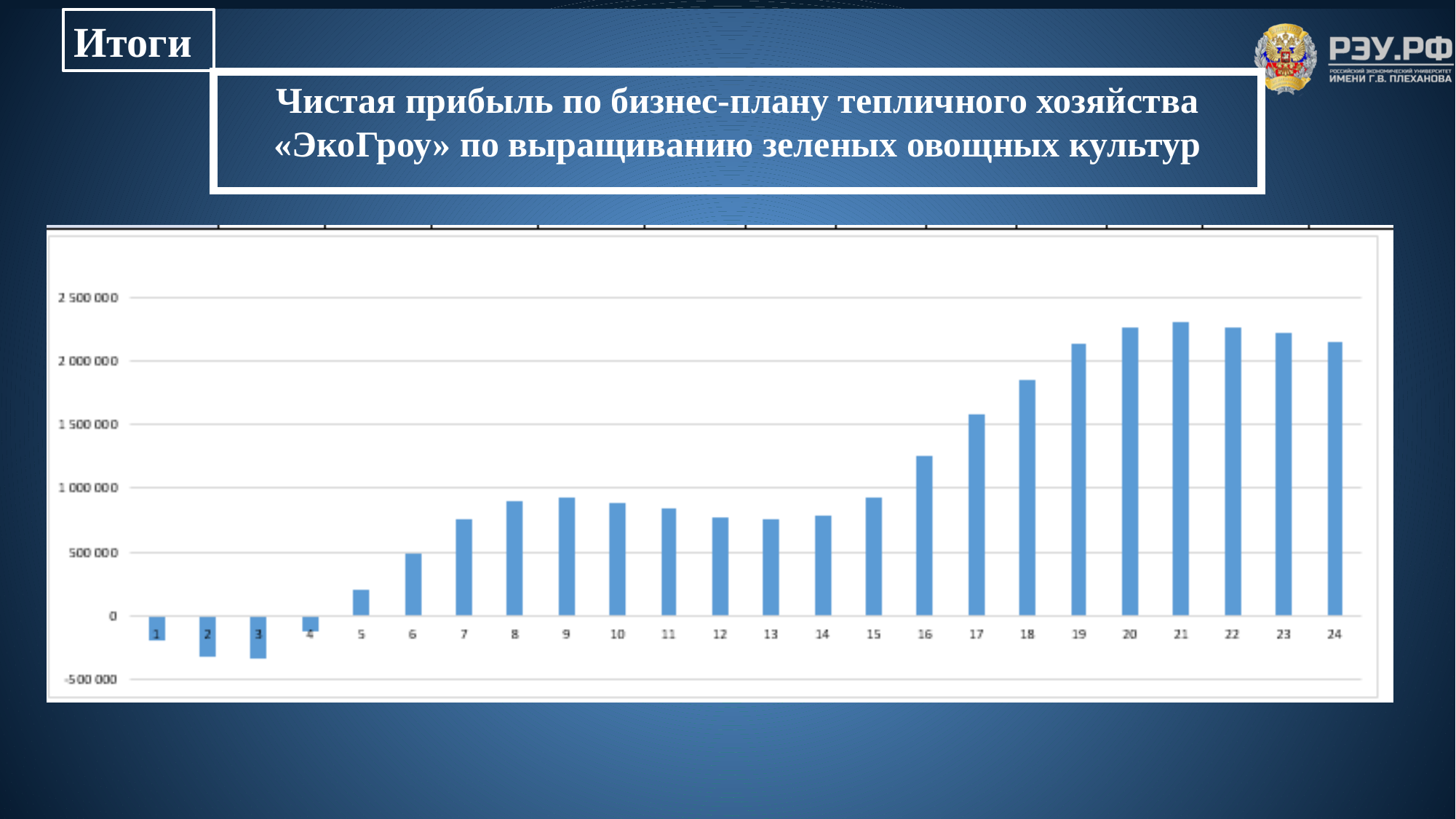
Is the value for period 16 greater or less than 1 000 000? greater Which period has the highest net profit bar? 21 What kind of chart is shown on the slide? bar chart How many categories (periods) are plotted along the x axis? 24 Do the values generally rise or fall from period 1 to period 21? rise Is the value for period 18 greater or less than 1 500 000? greater How many periods have a negative (below zero) value? 4 Is the value for period 12 greater or less than 1 000 000? less Which is larger, the value for period 4 or period 5? 5 Which is larger, the value for period 17 or period 18? 18